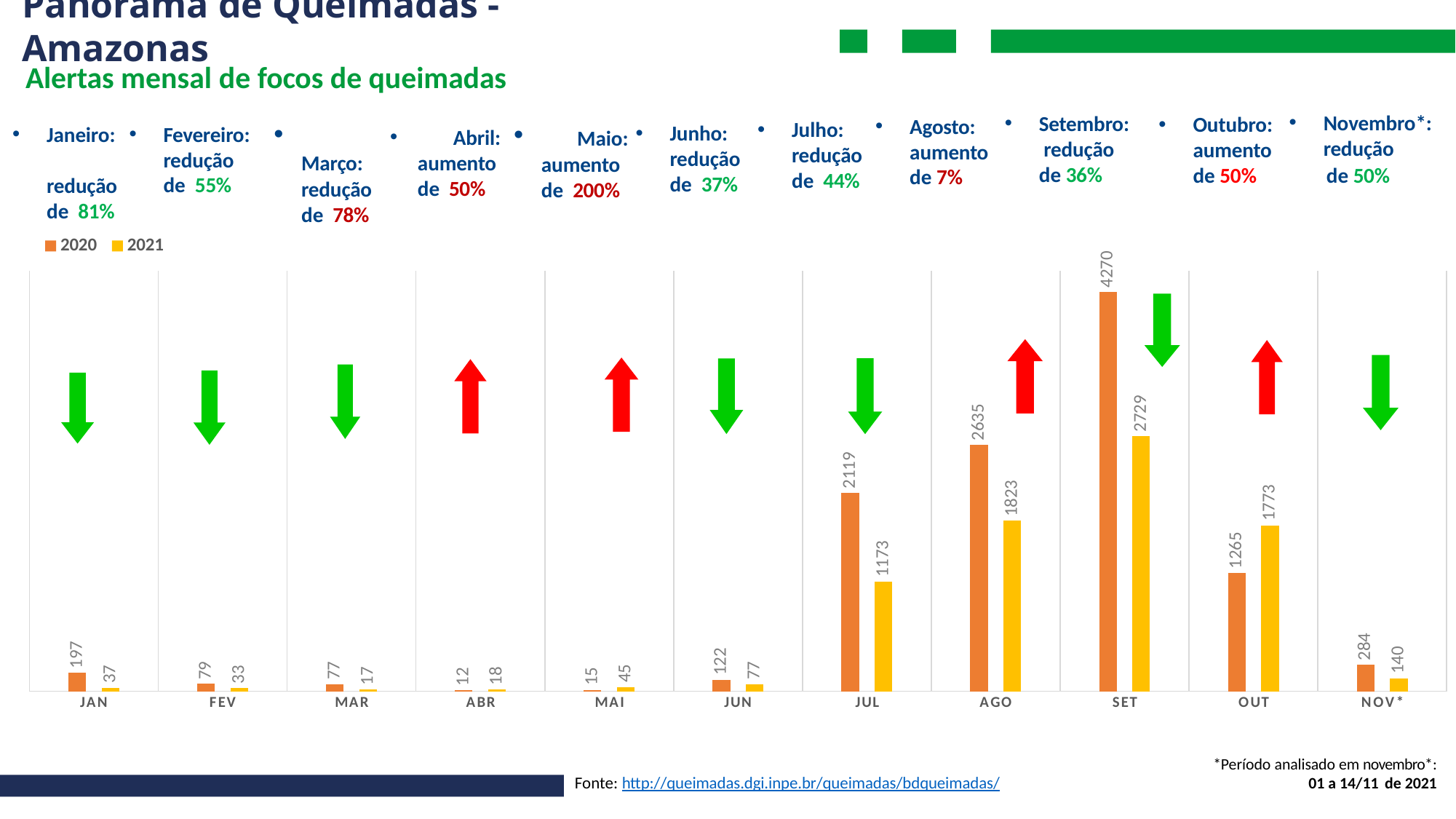
What kind of chart is shown on the slide? bar chart Which month has the lowest value for the 2021 series? MAR Which colour represents the 2021 series in the legend? yellow What is the value for 2020 in SET? 4270 What is the value for 2021 in OUT? 1773 What is the value for 2021 in JUL? 1173 How many series does the legend list? 2 What is the total of the 2020 and 2021 values in JAN? 234 How many months are shown on the x axis? 11 Which month has the highest value for the 2020 series? SET What is the difference between the 2020 and 2021 values in AGO? 812 Which is larger in OUT, the 2020 value or the 2021 value? 2021